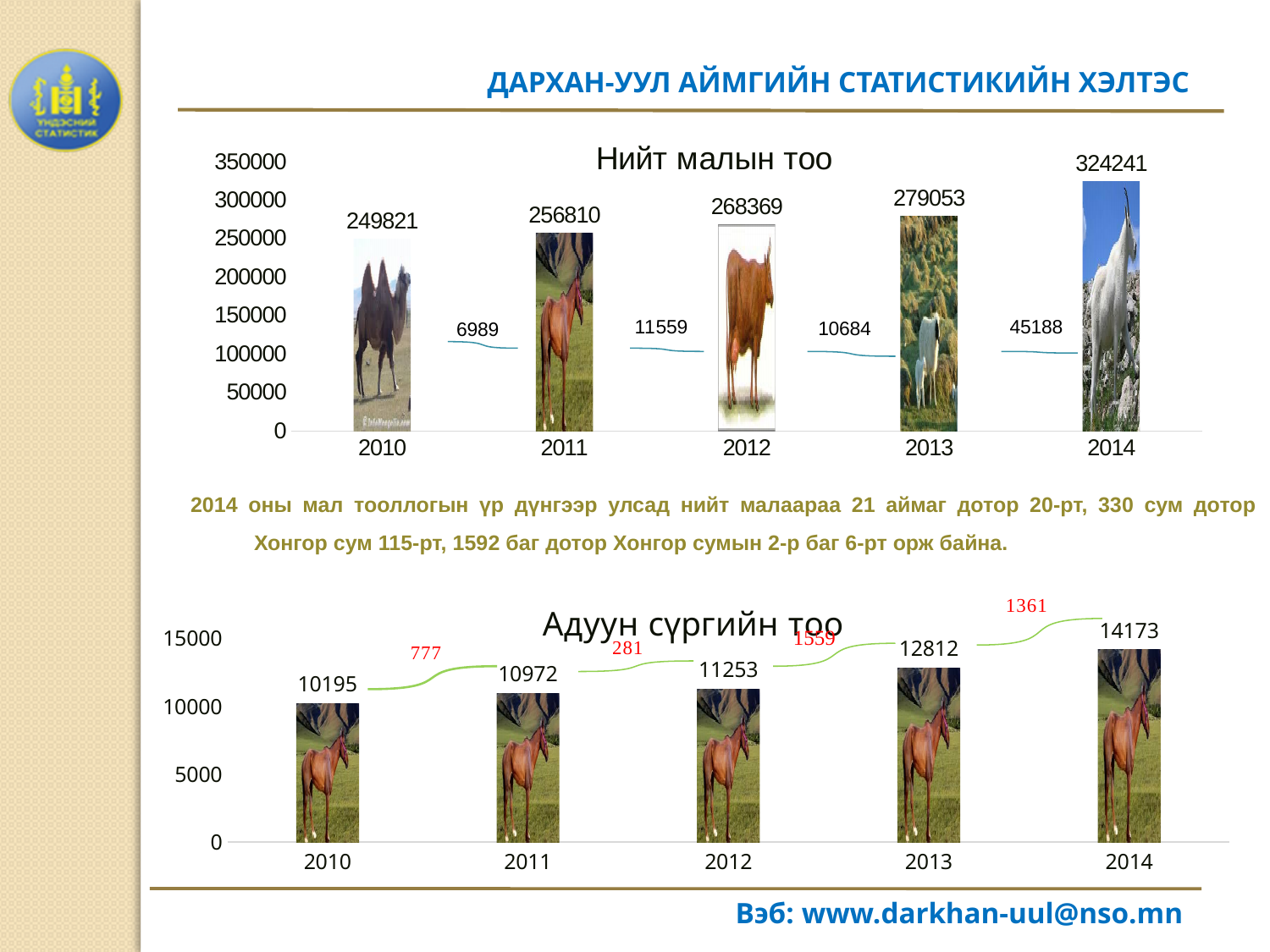
In the chart titled "Адуун сүргийн тоо", which is larger, the value for 2011 or the value for 2012? 2012 In the chart titled "Адуун сүргийн тоо", is the value for 2014 greater or less than 10000? greater In the chart titled "Нийт малын тоо", what is the difference between the 2014 value and the 2013 value? 45188 In the chart titled "Нийт малын тоо", what is the value for 2014? 324241 In the chart titled "Нийт малын тоо", what is the value for 2010? 249821 In the chart titled "Адуун сүргийн тоо", what is the difference between the 2012 value and the 2011 value? 281 In the chart titled "Адуун сүргийн тоо", which year has the lowest value? 2010 In the chart titled "Нийт малын тоо", how many years are shown on the x axis? 5 In the chart titled "Адуун сүргийн тоо", what is the value for 2013? 12812 In the chart titled "Нийт малын тоо", which year has the highest value? 2014 What kind of chart is the bottom chart on the slide? bar chart In the chart titled "Нийт малын тоо", do the values rise or fall from 2010 to 2014? rise